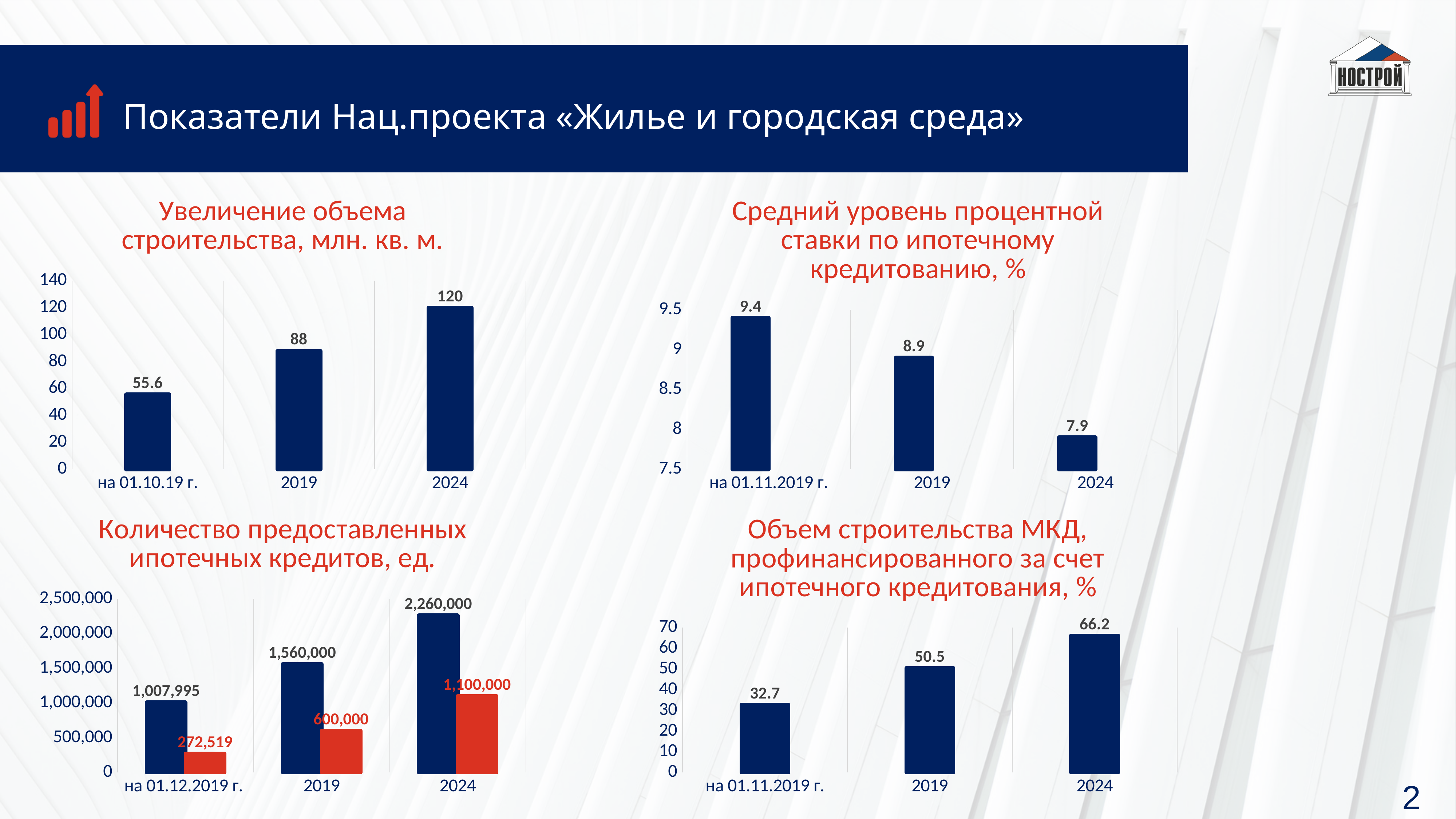
In the bottom-right chart 'Объем строительства МКД, профинансированного за счет ипотечного кредитования, %', which category has the highest value? 2024 In the top-left chart 'Увеличение объема строительства, млн. кв. м.', what is the value for 'на 01.10.19 г.'? 55.6 In the top-left chart 'Увеличение объема строительства, млн. кв. м.', what is the difference between the 2024 and 2019 values? 32 In the bottom-left chart 'Количество предоставленных ипотечных кредитов, ед.', how many categories are shown on the x axis? 3 In the top-right chart 'Средний уровень процентной ставки по ипотечному кредитованию, %', what is the value for 2019? 8.9 In the bottom-left chart 'Количество предоставленных ипотечных кредитов, ед.', what is the value of the blue bar for 2024? 2,260,000 In the bottom-right chart 'Объем строительства МКД, профинансированного за счет ипотечного кредитования, %', what is the value for 'на 01.11.2019 г.'? 32.7 What kind of chart is the bottom-right chart 'Объем строительства МКД, профинансированного за счет ипотечного кредитования, %'? bar chart In the top-left chart 'Увеличение объема строительства, млн. кв. м.', what is the value for 2024? 120 In the top-right chart 'Средний уровень процентной ставки по ипотечному кредитованию, %', do the values rise or fall from left to right along the x axis? fall In the bottom-left chart 'Количество предоставленных ипотечных кредитов, ед.', what is the value of the red bar for 'на 01.12.2019 г.'? 272,519 In the top-right chart 'Средний уровень процентной ставки по ипотечному кредитованию, %', which category has the lowest value? 2024